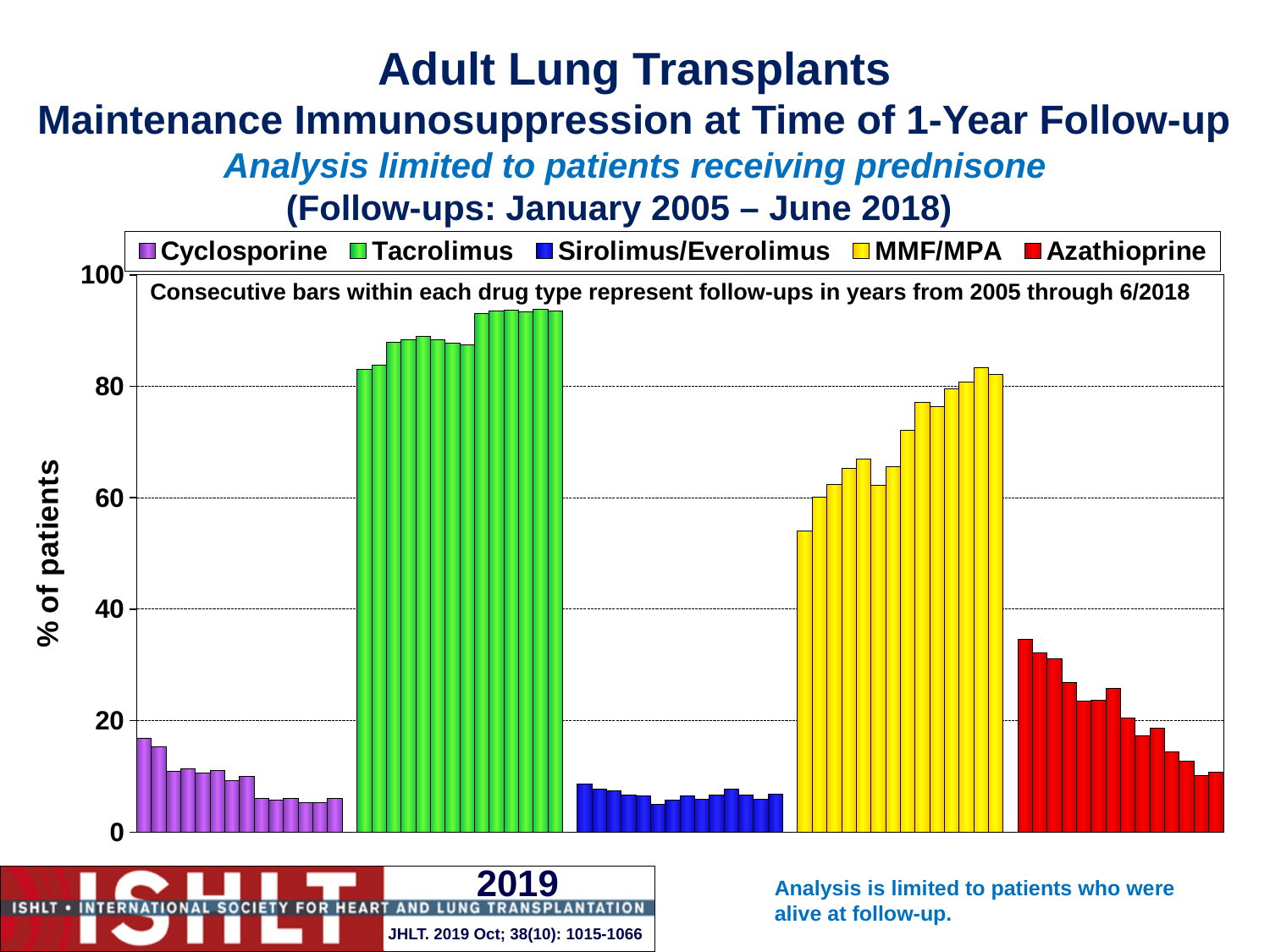
What kind of chart is shown on the slide? bar chart What is the label on the y axis of the chart? % of patients Do the Cyclosporine bars rise or fall from 2005 through 2018? fall Are the Tacrolimus values greater or less than 80% of patients? greater Do the Tacrolimus bars rise or fall from 2005 through 2018? rise Which drug type has the lowest percentage of patients across the chart? Sirolimus/Everolimus Is the first (2005) MMF/MPA bar greater or less than 40% of patients? greater How many drug types (series) does the legend list? 5 Which drug type has the highest percentage of patients across the chart? Tacrolimus Are the Cyclosporine values greater or less than 20% of patients? less Do the Azathioprine bars rise or fall from 2005 through 2018? fall Which drug type has higher values, Tacrolimus or MMF/MPA? Tacrolimus